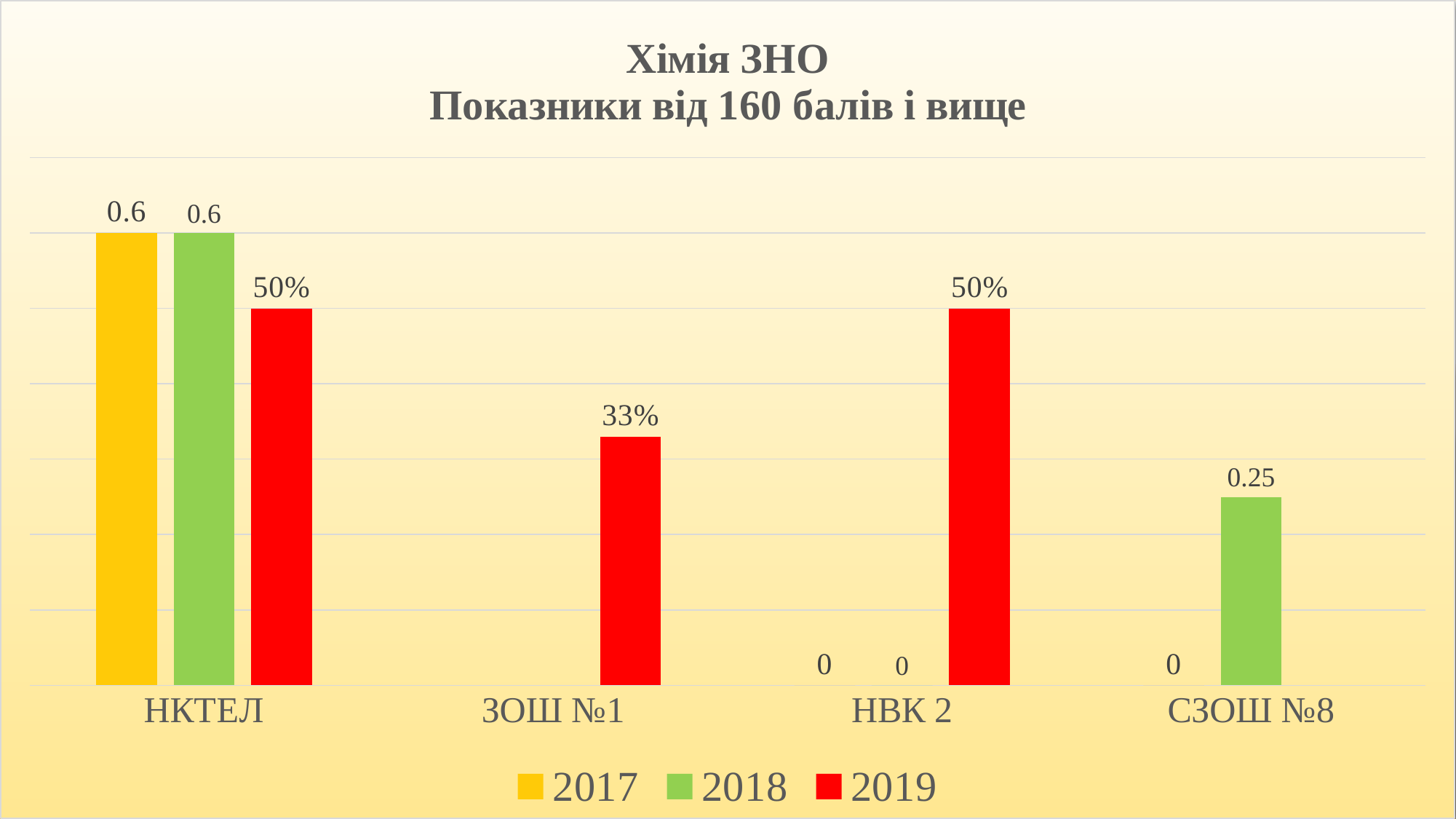
What is the value for СЗОШ №8 in the 2018 series? 0.25 What is the value for ЗОШ №1 in the 2019 series? 33% How many series does the legend list? 3 What kind of chart is shown on the slide? Bar chart What is the value for НВК 2 in the 2017 series? 0 Which is larger in the 2018 series: НКТЕЛ or СЗОШ №8? НКТЕЛ Which colour represents the 2019 series in the legend? Red What is the value for НКТЕЛ in the 2017 series? 0.6 What is the value for НКТЕЛ in the 2019 series? 50% How many categories are shown on the x axis? 4 Which category has the lowest value in the 2019 series among those with a labelled bar? ЗОШ №1 What is the value for НВК 2 in the 2019 series? 50%